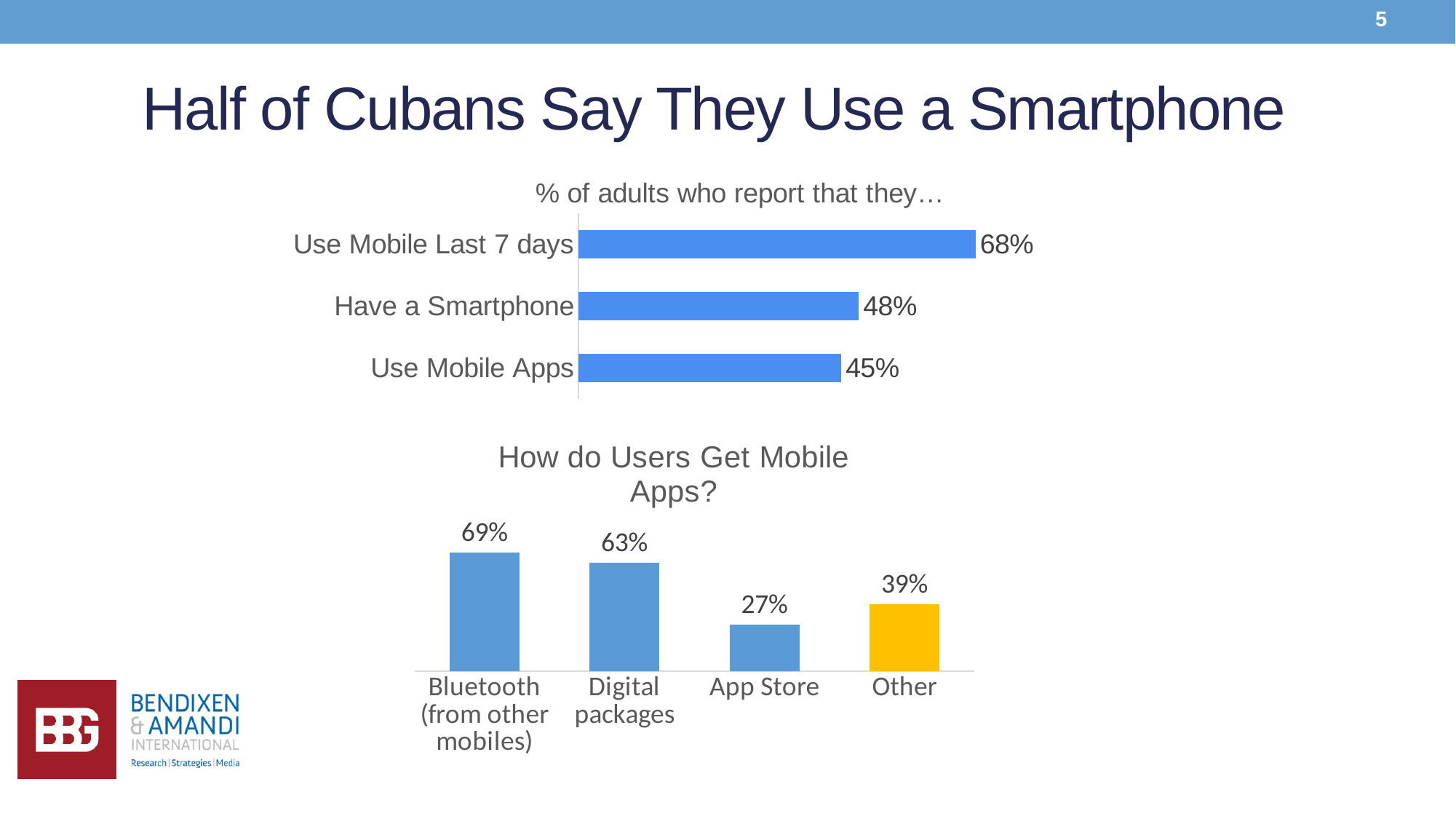
In the bottom chart titled 'How do Users Get Mobile Apps?', which category has the lowest value? App Store In the top chart titled '% of adults who report that they…', how many categories are shown? 3 In the bottom chart titled 'How do Users Get Mobile Apps?', what is the value for 'App Store'? 27% In the top chart titled '% of adults who report that they…', what is the value for 'Have a Smartphone'? 48% In the top chart titled '% of adults who report that they…', what is the difference between 'Use Mobile Last 7 days' and 'Have a Smartphone'? 20% In the top chart titled '% of adults who report that they…', which category has the highest value? Use Mobile Last 7 days In the bottom chart titled 'How do Users Get Mobile Apps?', what is the difference between 'Bluetooth (from other mobiles)' and 'Digital packages'? 6% In the bottom chart titled 'How do Users Get Mobile Apps?', which category's bar is coloured yellow? Other In the bottom chart titled 'How do Users Get Mobile Apps?', what is the value for 'Other'? 39% In the top chart titled '% of adults who report that they…', what is the value for 'Use Mobile Apps'? 45% In the bottom chart titled 'How do Users Get Mobile Apps?', which is larger: 'Digital packages' or 'Other'? Digital packages In the top chart titled '% of adults who report that they…', what kind of chart is it? Bar chart